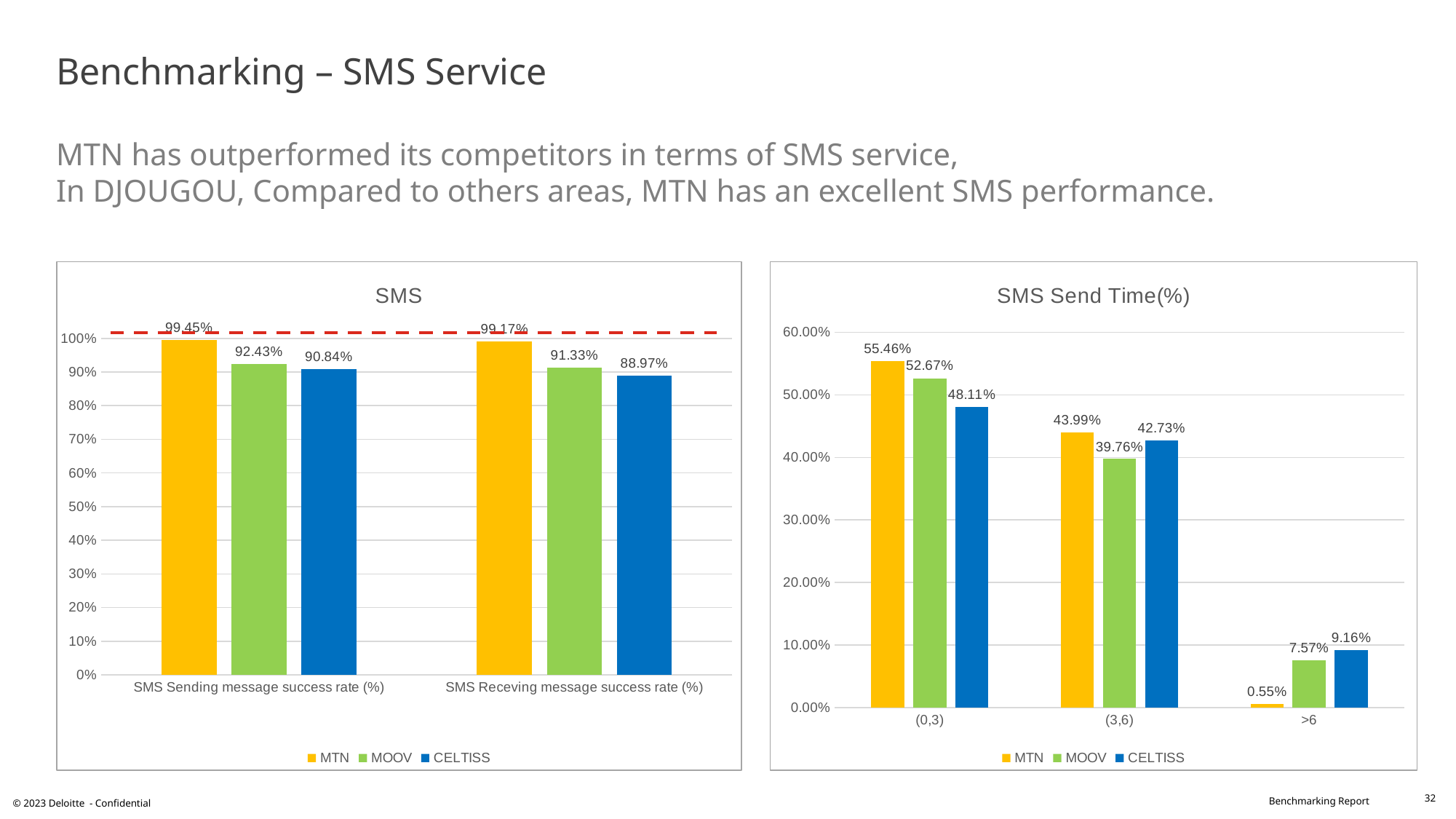
In the 'SMS Send Time(%)' chart, what is the value for MOOV in the (3,6) category? 39.76% In the 'SMS' chart, which operator has the lowest SMS Sending message success rate (%)? CELTISS In the 'SMS Send Time(%)' chart, what is the value for MTN in the >6 category? 0.55% In the 'SMS Send Time(%)' chart, which operator has the highest value in the (0,3) category? MTN In the 'SMS Send Time(%)' chart, do MTN's values rise or fall from (0,3) to >6? fall In the 'SMS' chart, how many series does the legend list? 3 In the 'SMS' chart, what is the SMS Receving message success rate (%) for CELTISS? 88.97% In the 'SMS Send Time(%)' chart, is the value for CELTISS in the (0,3) category larger or smaller than the value for MOOV in the same category? smaller In the 'SMS Send Time(%)' chart, how many categories are shown on the x axis? 3 In the 'SMS' chart, what is the SMS Sending message success rate (%) for MTN? 99.45% What kind of chart is the 'SMS Send Time(%)' chart? bar chart In the 'SMS' chart, what is the difference between MTN's and MOOV's SMS Receving message success rate (%)? 7.84%